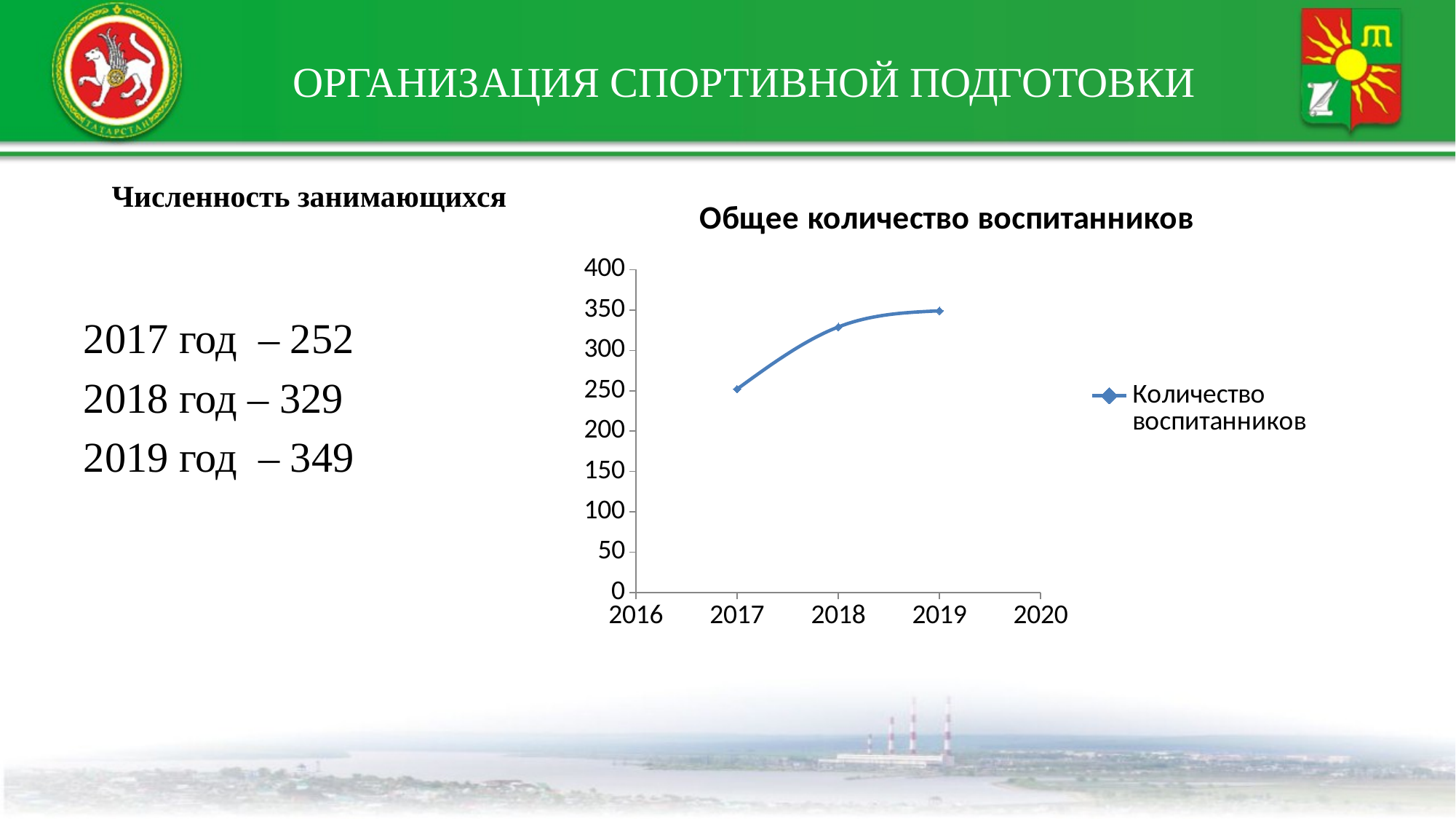
What is the title of the chart? Общее количество воспитанников What is the name of the series in the chart legend? Количество воспитанников Do the values rise or fall from 2017 to 2019? rise Which year has the highest number of воспитанников? 2019 Which year has the lowest number of воспитанников? 2017 How many data points are plotted on the line? 3 What kind of chart is shown on the slide? line chart Which is larger, the value for 2017 or the value for 2018? 2018 Is the value for 2019 greater or less than 300? greater Is the value for 2017 greater or less than 300? less What is the number of воспитанников in 2018? 329 How many series does the chart legend list? 1